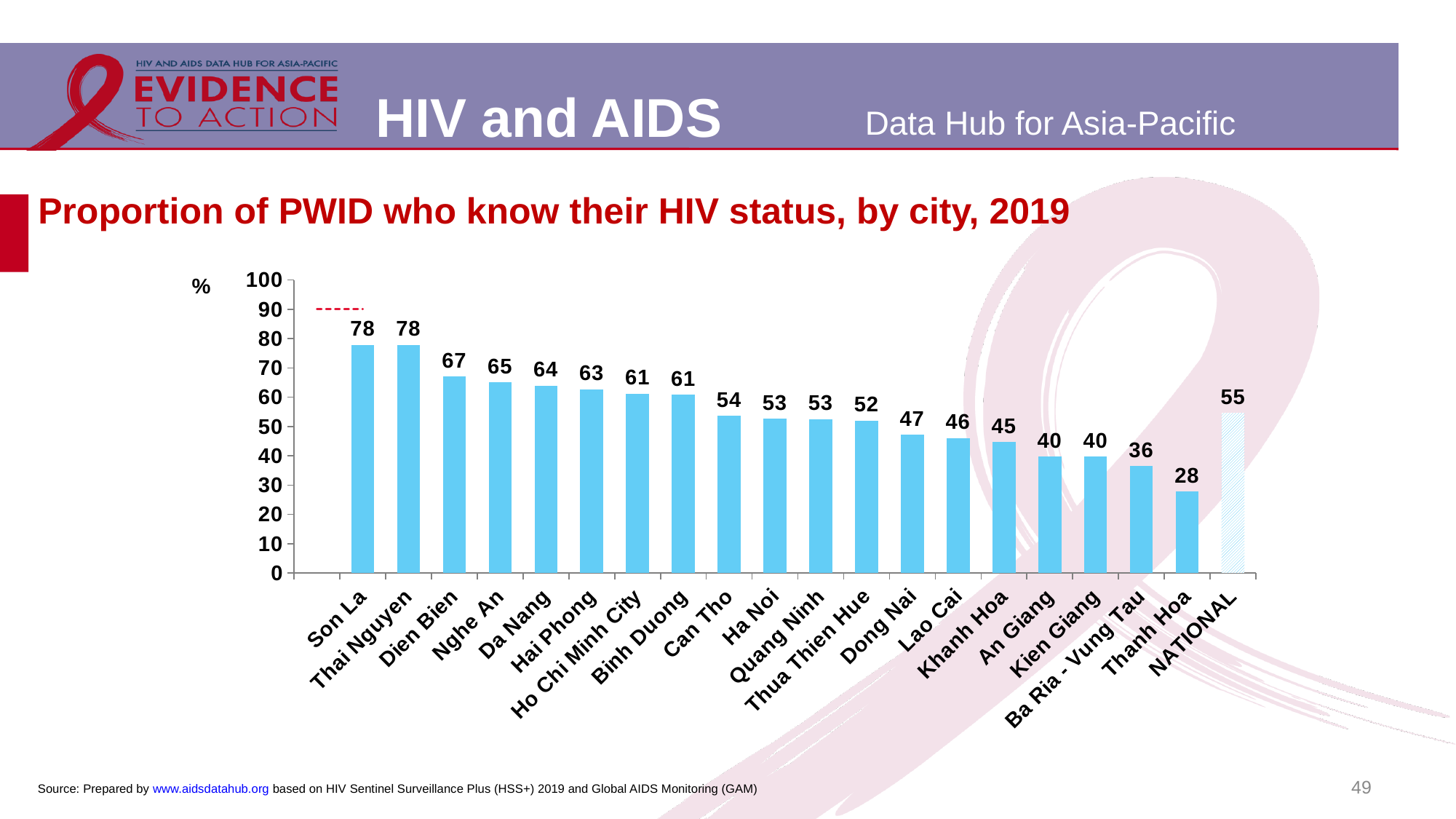
Which is larger, the value for Can Tho or the value for Ha Noi? Can Tho What is the value for Dien Bien? 67 What unit is shown on the y axis of the chart? % What is the value for Ba Ria - Vung Tau? 36 How many bars are plotted on the chart? 20 What is the difference between the values for Dien Bien and Nghe An? 2 What is the value for Ho Chi Minh City? 61 Which city has the lowest proportion of PWID who know their HIV status? Thanh Hoa What kind of chart is shown on the slide? Bar chart What is the NATIONAL value shown on the chart? 55 Do the city values rise or fall from left to right across the chart (before the NATIONAL bar)? Fall What is the difference between the values for Son La and Thanh Hoa? 50